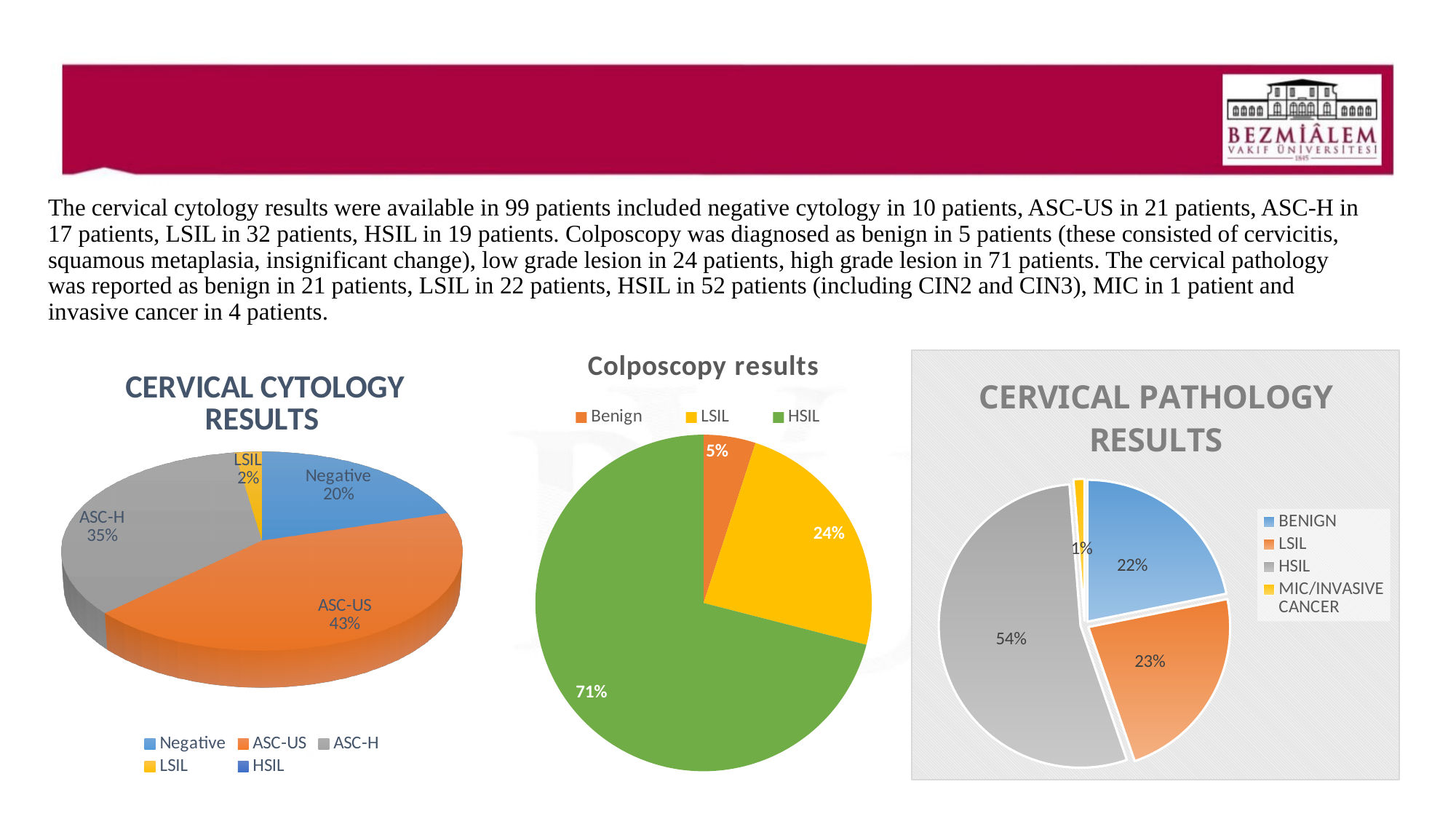
In the Cervical Pathology Results chart, what percentage is shown for HSIL? 54% In the Cervical Cytology Results chart, what percentage is shown for ASC-H? 35% In the Colposcopy results chart, what percentage is shown for HSIL? 71% In the Cervical Pathology Results chart, what percentage is shown for MIC/INVASIVE CANCER? 1% In the Cervical Pathology Results chart, which category has the largest share? HSIL What kind of chart is the Colposcopy results chart? Pie chart In the Cervical Pathology Results chart, what colour is the HSIL slice? Grey In the Colposcopy results chart, what is the difference between the LSIL and Benign percentages? 19% In the Colposcopy results chart, how many categories are shown? 3 In the Cervical Cytology Results chart, how many entries does the legend list? 5 In the Cervical Cytology Results chart, what percentage is shown for ASC-US? 43% In the Cervical Cytology Results chart, which category has the smallest labelled slice? LSIL